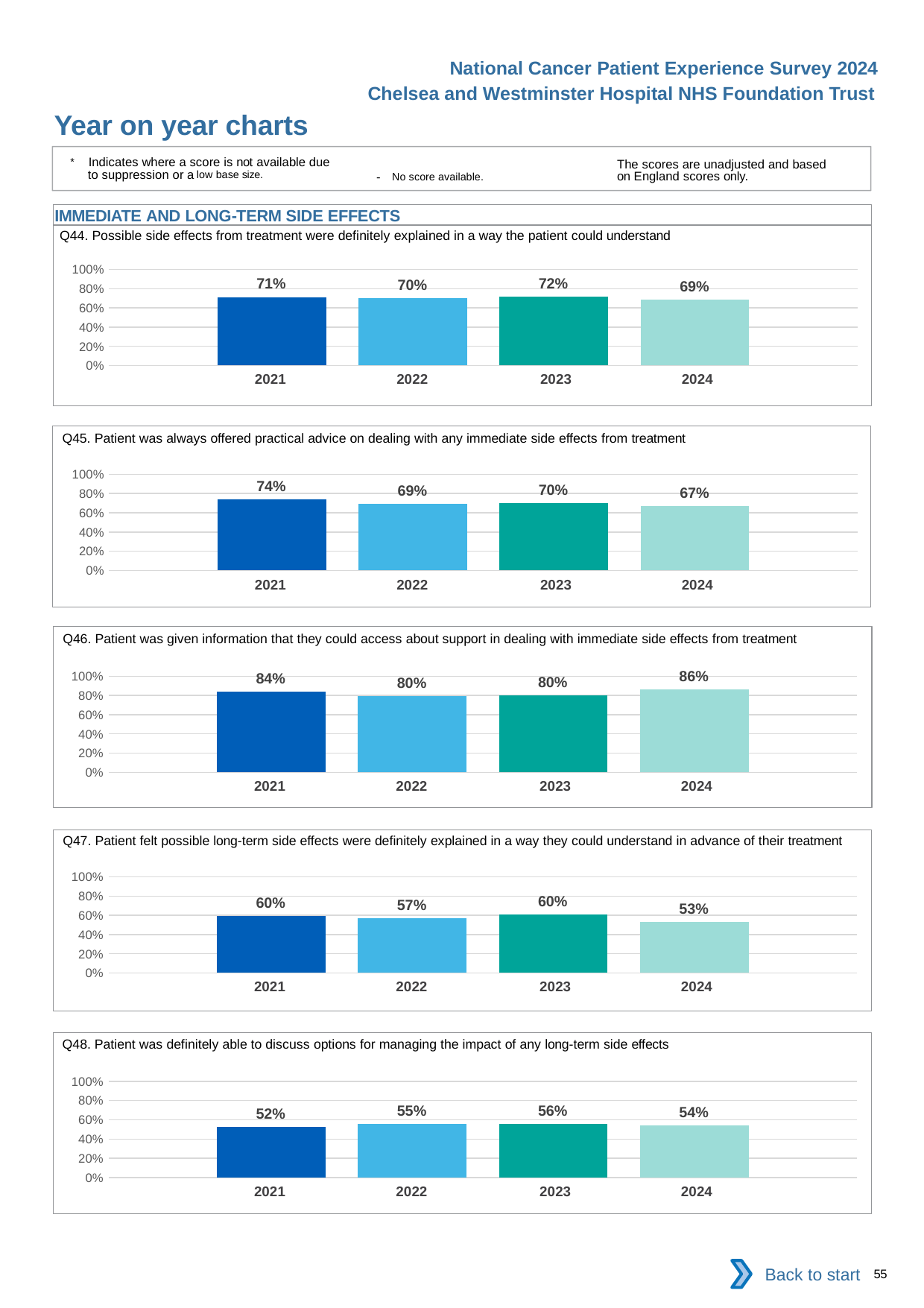
In the Q45 chart, which year has the highest value? 2021 What kind of chart is the Q47 chart? bar chart In the Q48 chart, is the value for 2023 greater or less than 60%? less In the Q45 chart, what is the difference between the 2021 and 2024 values? 7 percentage points In the Q47 chart, is the value for 2022 larger or smaller than the value for 2023? smaller In the Q48 chart, what is the value for 2022? 55% In the Q46 chart, what is the value for 2021? 84% In the Q44 chart, what is the value for 2023? 72% In the Q46 chart, which year has the highest value? 2024 In the Q47 chart, which year has the lowest value? 2024 In the Q48 chart, which year has the lowest value? 2021 How many years are shown in the Q44 chart? 4